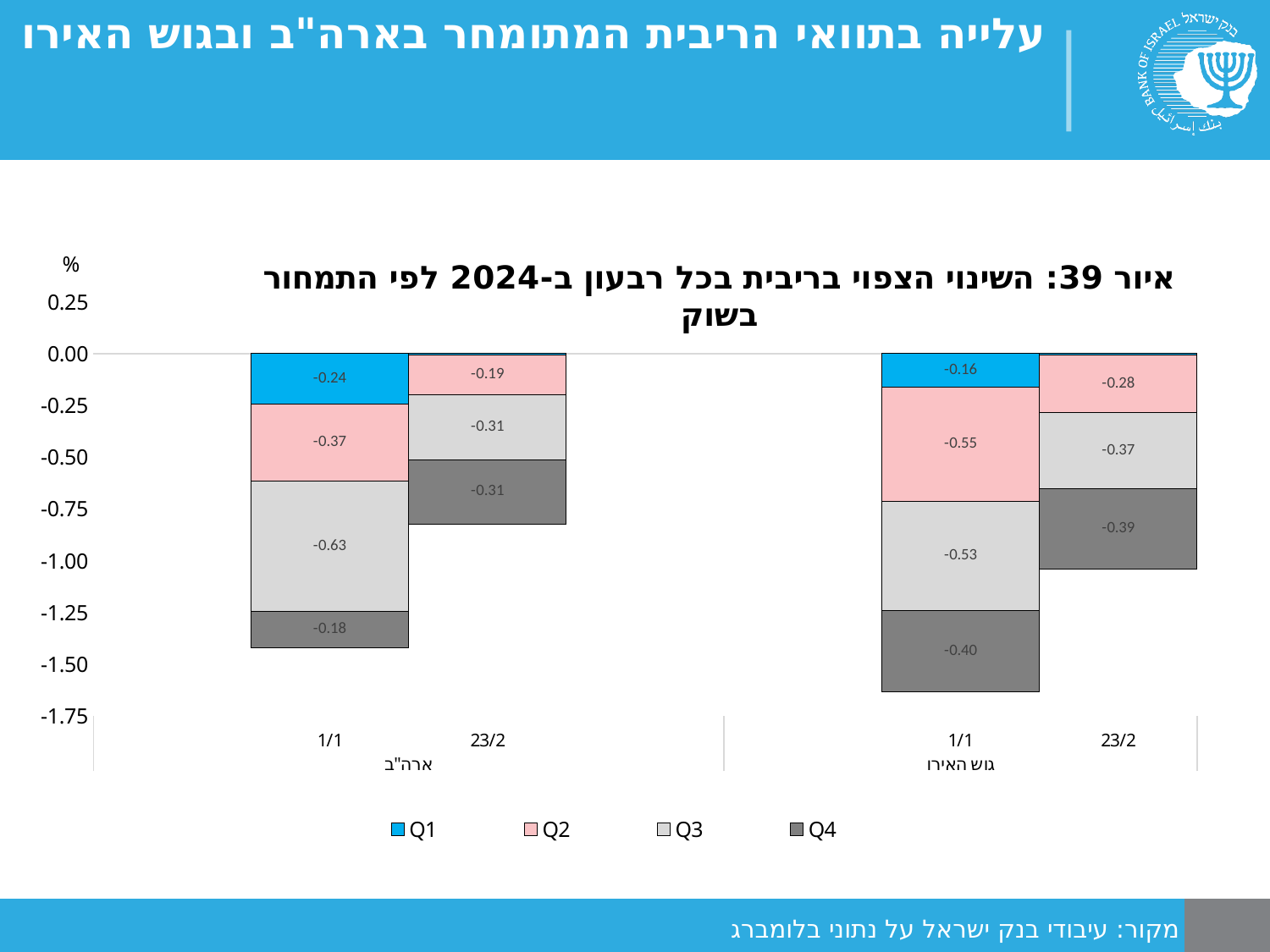
What is the total of the stacked Eurozone (גוש האירו) 1/1 bar? -1.64 What is the total of the stacked US (ארה"ב) 1/1 bar? -1.42 How many series does the legend list? 4 What is the Q2 value for the Eurozone (גוש האירו) 1/1 bar? -0.55 What is the difference between the Q3 values of the US 1/1 bar (-0.63) and the US 23/2 bar (-0.31)? 0.32 What kind of chart is shown on the slide? Stacked bar chart What is the Q4 value for the Eurozone (גוש האירו) 23/2 bar? -0.39 What is the Q1 value for the US (ארה"ב) 1/1 bar? -0.24 Which has a larger magnitude: the Q4 segment of the Eurozone 1/1 bar or the Q4 segment of the US 1/1 bar? Eurozone 1/1 (-0.40) Which colour represents Q1 in the legend? Blue What is the Q3 value for the US (ארה"ב) 1/1 bar? -0.63 What is the Q2 value for the US (ארה"ב) 23/2 bar? -0.19